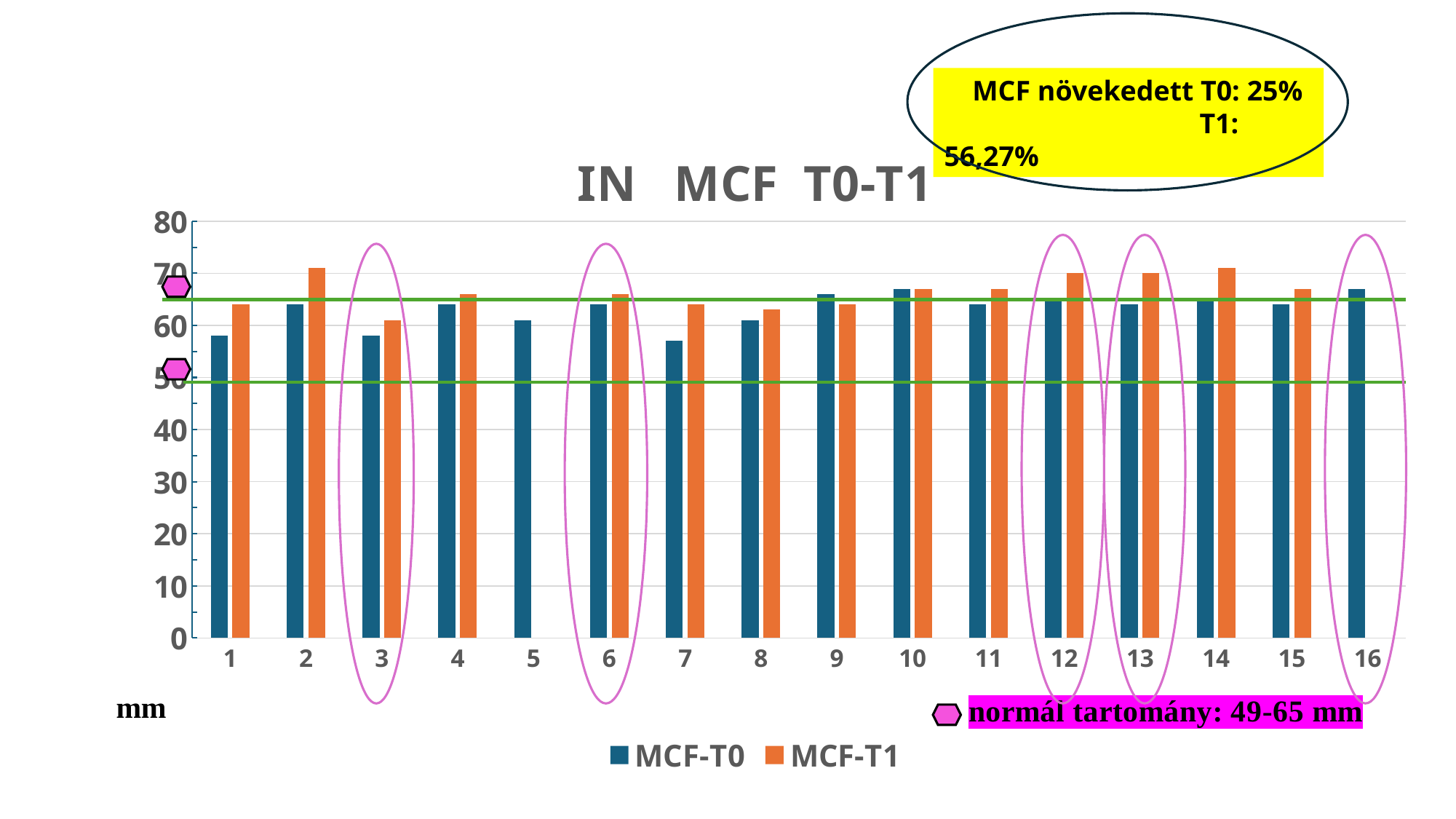
Is the MCF-T1 value for category 12 greater or less than 60? greater What is the title of the chart? IN MCF T0-T1 For category 7, which is larger: MCF-T0 or MCF-T1? MCF-T1 How many categories are shown on the x axis? 16 What kind of chart is shown on the slide? bar chart Is the MCF-T0 value for category 1 greater or less than 60? less For category 13, which is larger: MCF-T0 or MCF-T1? MCF-T1 Is the MCF-T1 value for category 1 greater or less than 60? greater How many series does the legend list? 2 What are the two series named in the legend? MCF-T0 and MCF-T1 For category 1, which is larger: MCF-T0 or MCF-T1? MCF-T1